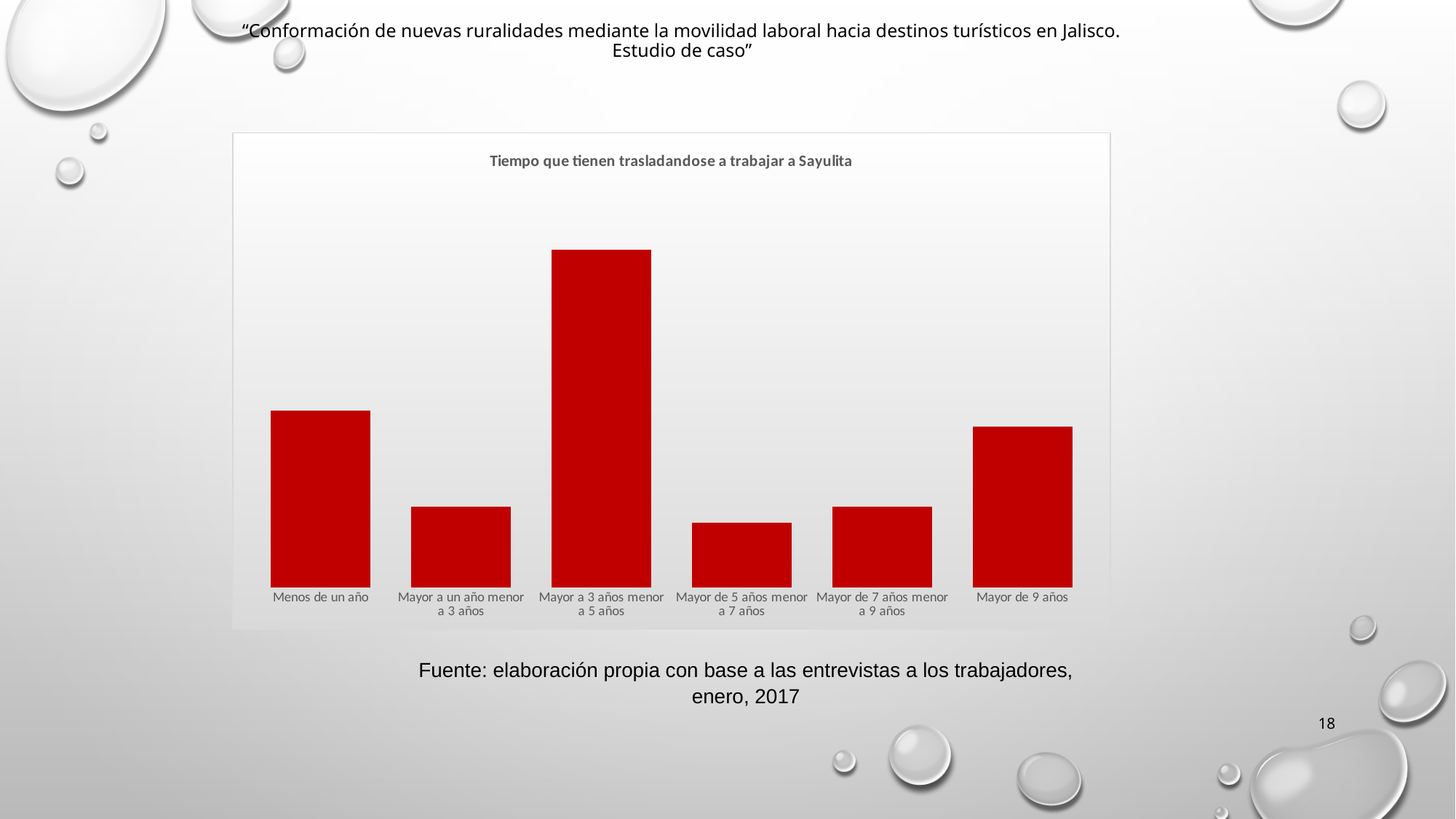
How many categories are shown on the x axis of the chart? 6 What type of chart is shown on the slide? Bar chart What is the title of the chart? Tiempo que tienen trasladandose a trabajar a Sayulita Which category has the lowest bar in the chart? Mayor de 5 años menor a 7 años Which category has the highest bar in the chart? Mayor a 3 años menor a 5 años What is the label of the first category on the x axis? Menos de un año Which is larger: the bar for 'Menos de un año' or the bar for 'Mayor a 3 años menor a 5 años'? Mayor a 3 años menor a 5 años Which is larger: the bar for 'Mayor de 9 años' or the bar for 'Mayor a un año menor a 3 años'? Mayor de 9 años Which is larger: the bar for 'Mayor de 9 años' or the bar for 'Mayor de 7 años menor a 9 años'? Mayor de 9 años What colour are the bars in the chart? Red